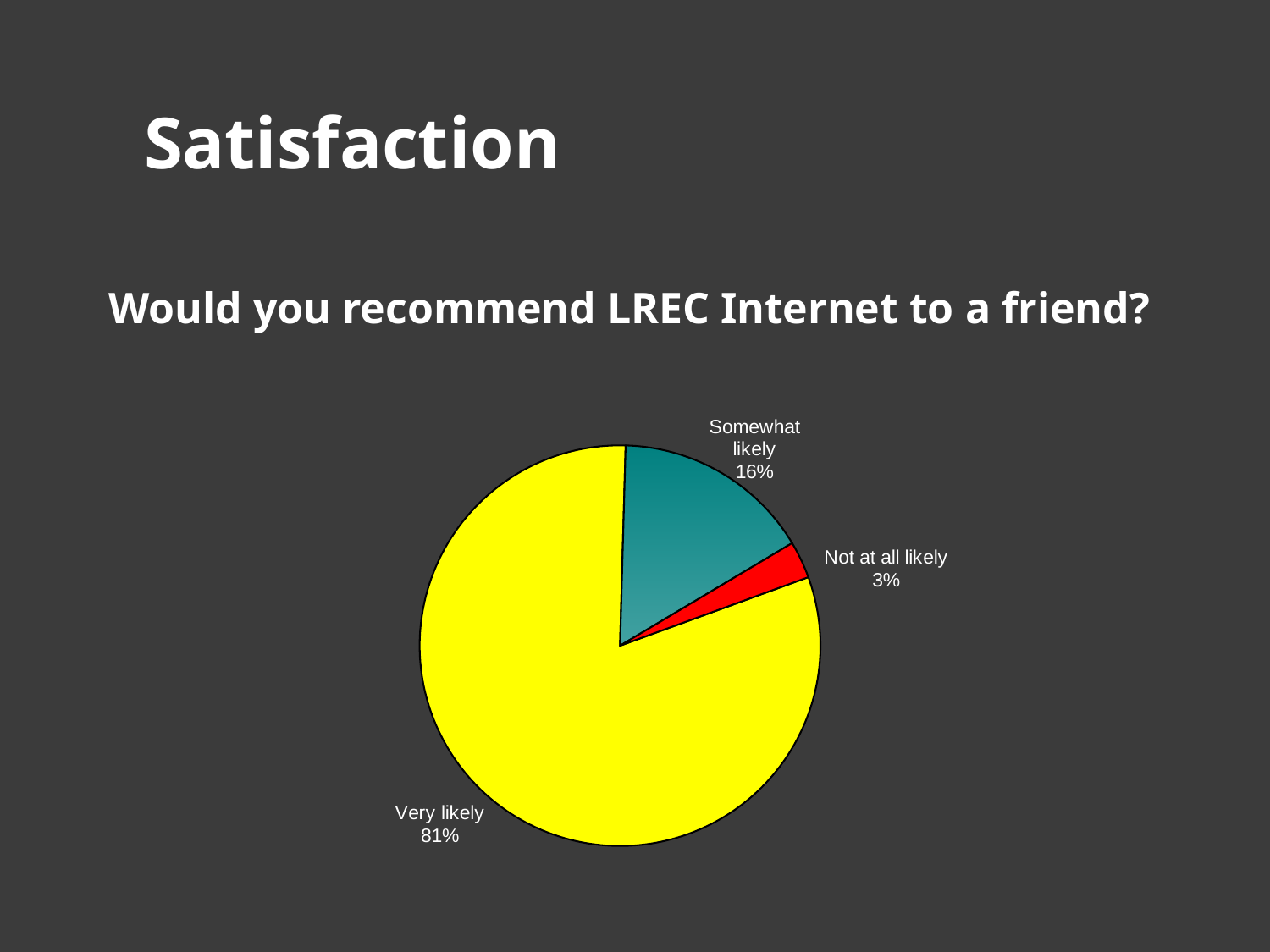
What percentage of respondents said they are not at all likely to recommend LREC Internet? 3% What is the difference in percentage points between the 'Very likely' and 'Somewhat likely' slices? 65 What colour is the 'Very likely' slice? Yellow What kind of chart is shown on the slide? Pie chart What percentage of respondents said they are somewhat likely to recommend LREC Internet? 16% Which response has the largest share of the pie? Very likely What share of the pie does the 'Very likely' slice represent? 81% Which slice is larger: 'Somewhat likely' or 'Not at all likely'? Somewhat likely What is the difference in percentage points between the 'Somewhat likely' and 'Not at all likely' slices? 13 How many slices does the pie chart have? 3 What percentage of respondents said they are very likely to recommend LREC Internet to a friend? 81% Which response has the smallest share of the pie? Not at all likely